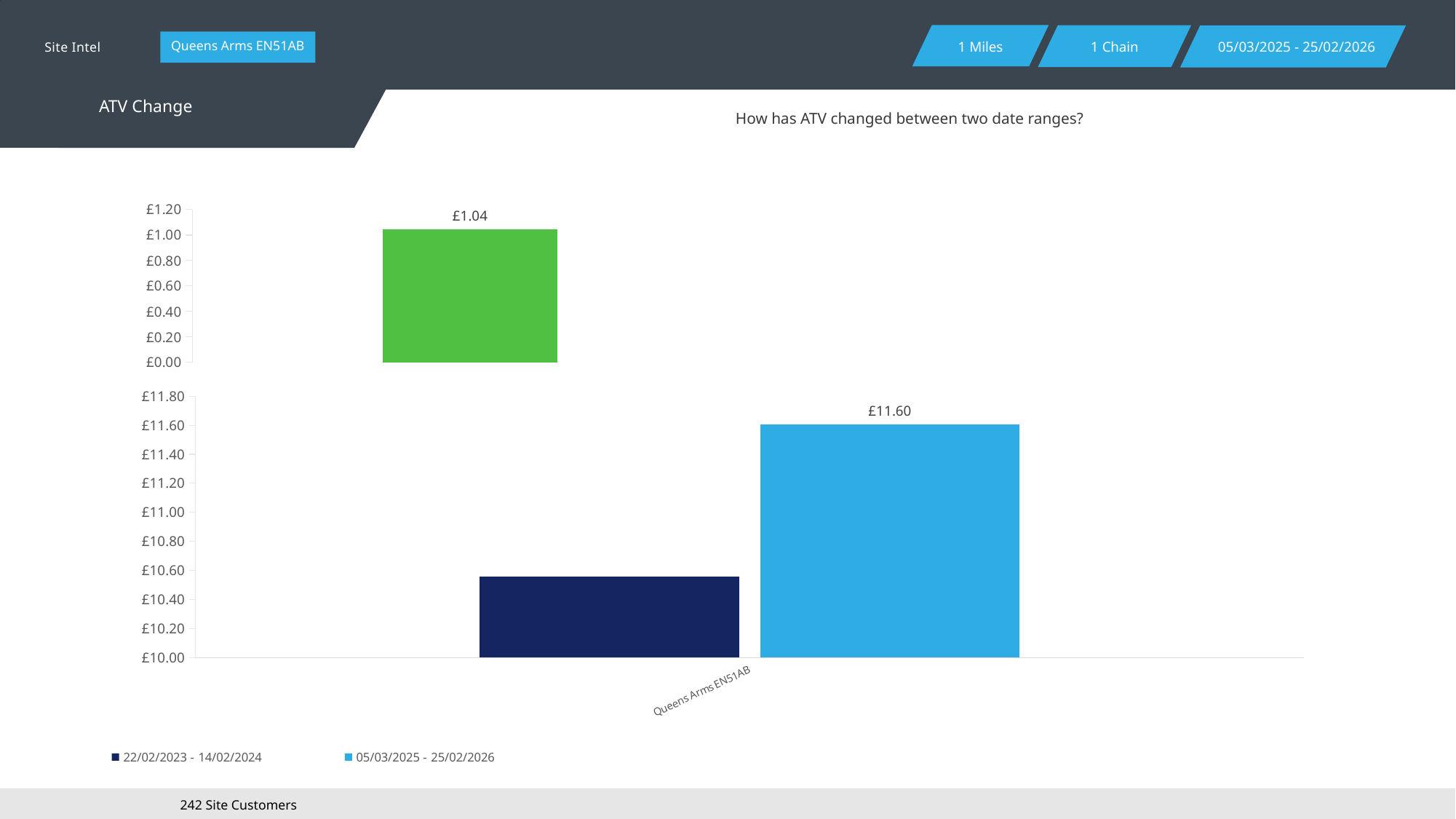
How many bars are plotted on the top chart? 1 On the bottom chart, what is the ATV value for the 05/03/2025 - 25/02/2026 period? £11.60 What kind of chart is the bottom chart? bar chart How many series does the legend of the bottom chart list? 2 On the top chart, is the value of the green bar greater or less than £1.00? greater On the bottom chart, is the value for 22/02/2023 - 14/02/2024 greater or less than £11.00? less In the legend of the bottom chart, which colour represents 22/02/2023 - 14/02/2024? dark navy blue On the top chart, what value is shown on the green bar? £1.04 On the bottom chart, which series has the highest bar? 05/03/2025 - 25/02/2026 On the bottom chart, is the value for 22/02/2023 - 14/02/2024 greater or less than £10.40? greater On the bottom chart, which period has the higher ATV: 22/02/2023 - 14/02/2024 or 05/03/2025 - 25/02/2026? 05/03/2025 - 25/02/2026 What is the category label on the x axis of the bottom chart? Queens Arms EN51AB